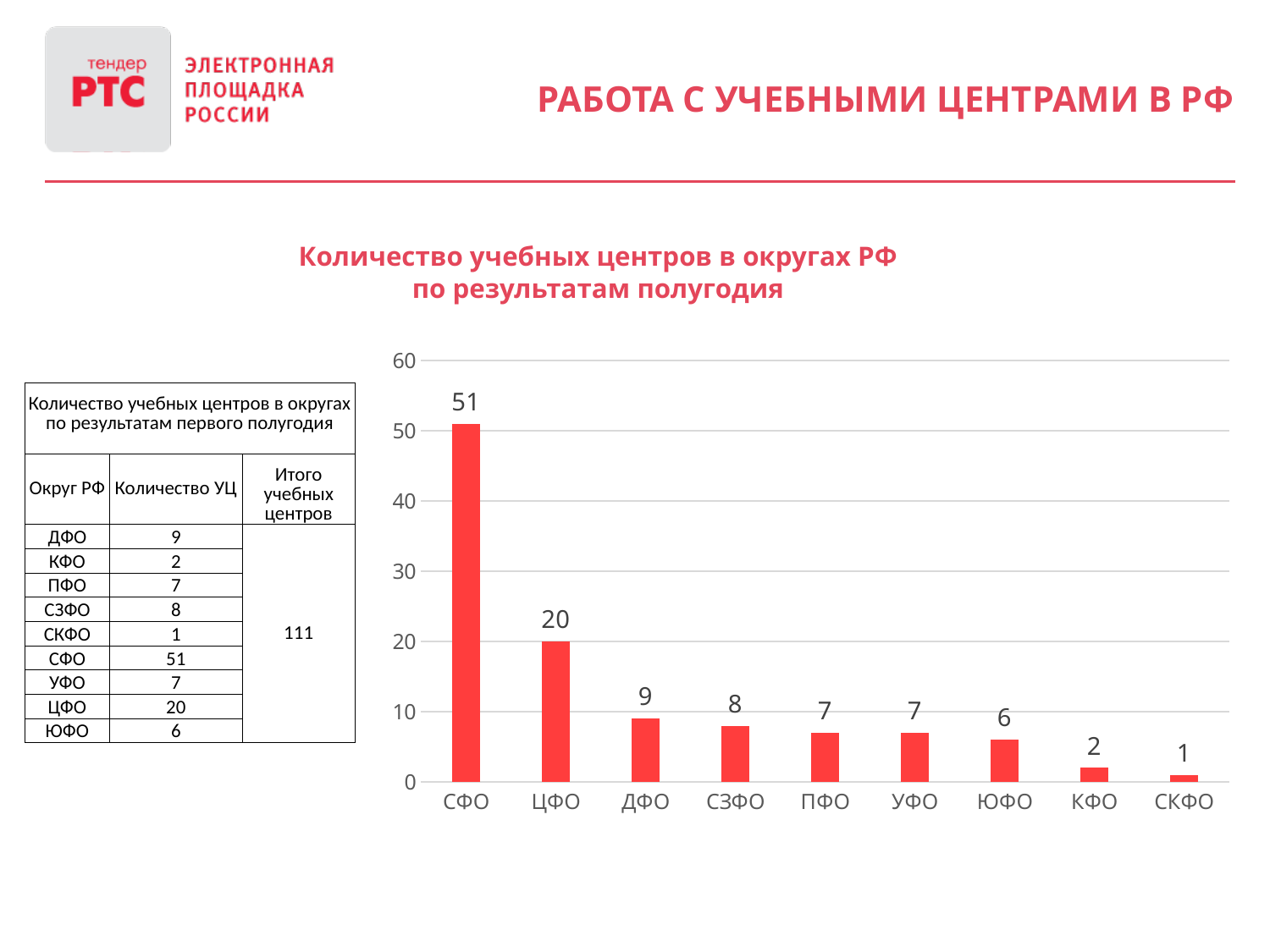
Which category has the highest value in the chart? СФО What is the value for ЮФО in the chart? 6 Which is larger, the value for ДФО or the value for КФО? ДФО What is the value for СЗФО in the chart? 8 What is the value for ЦФО in the chart? 20 Which category has the lowest value in the chart? СКФО What is the value for СФО in the chart? 51 What is the difference between the values for СФО and ЦФО? 31 How many categories are shown on the x axis of the chart? 9 What kind of chart is shown on the slide? bar chart Do the values rise or fall from left to right along the x axis? fall Is the value for ЦФО greater or less than 30? less